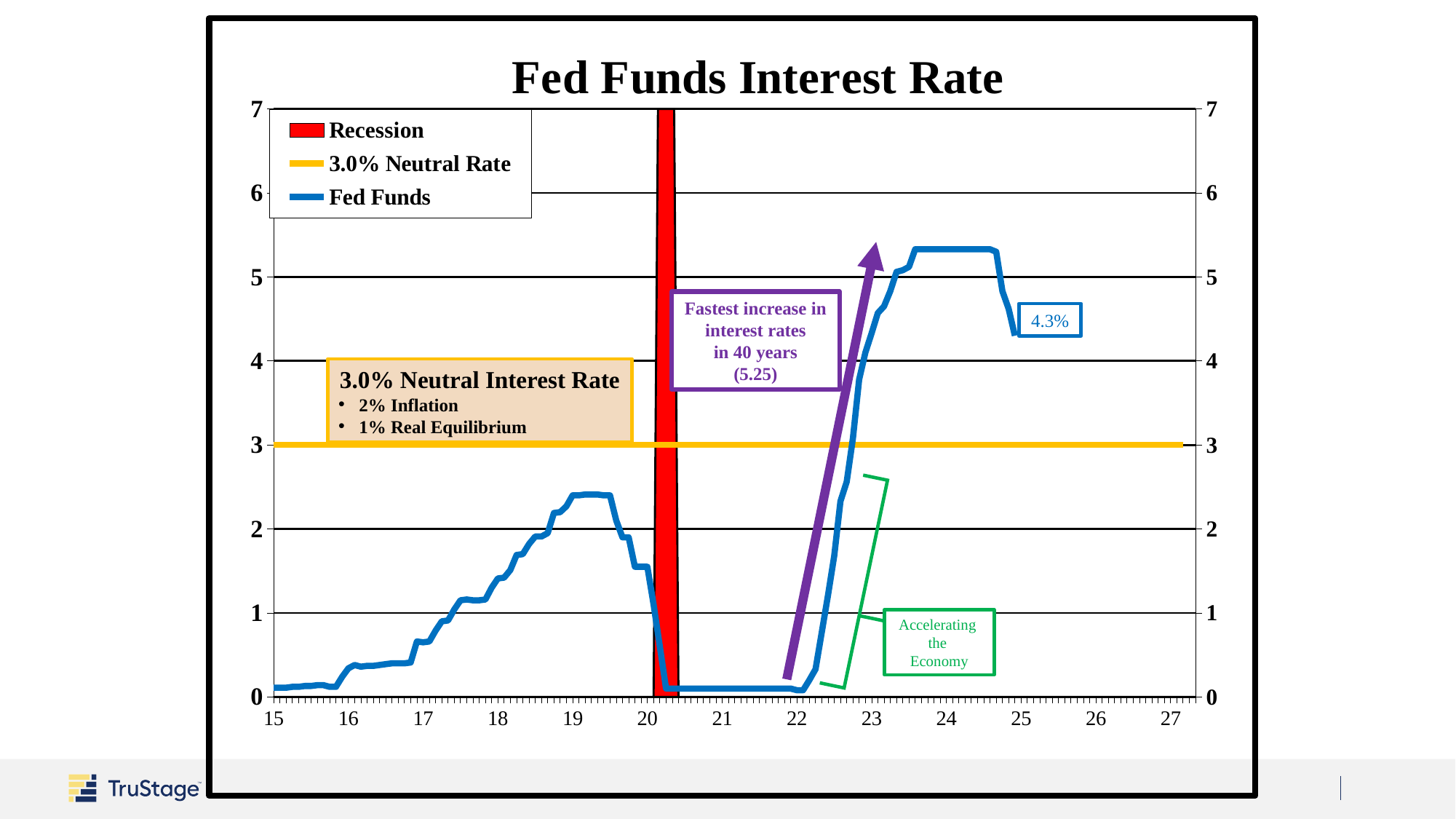
Is the Fed Funds value at 19 greater or less than 3? less What does the red shaded bar on the chart represent, according to the legend? Recession How many entries does the chart legend list? 3 At what level is the neutral rate line drawn, according to the legend? 3.0% Is the Fed Funds value at 24 greater or less than 5? greater What kind of chart is shown on the slide? line chart Around which year on the x axis does the Fed Funds line reach its highest level? 24 What value is printed as the data label at the end of the Fed Funds line? 4.3% Does the Fed Funds line rise or fall between 22 and 23? rise What is the title of the chart? Fed Funds Interest Rate Which is larger, the Fed Funds value at 24 or at 19? 24 Is the Fed Funds value at 21 greater or less than 1? less